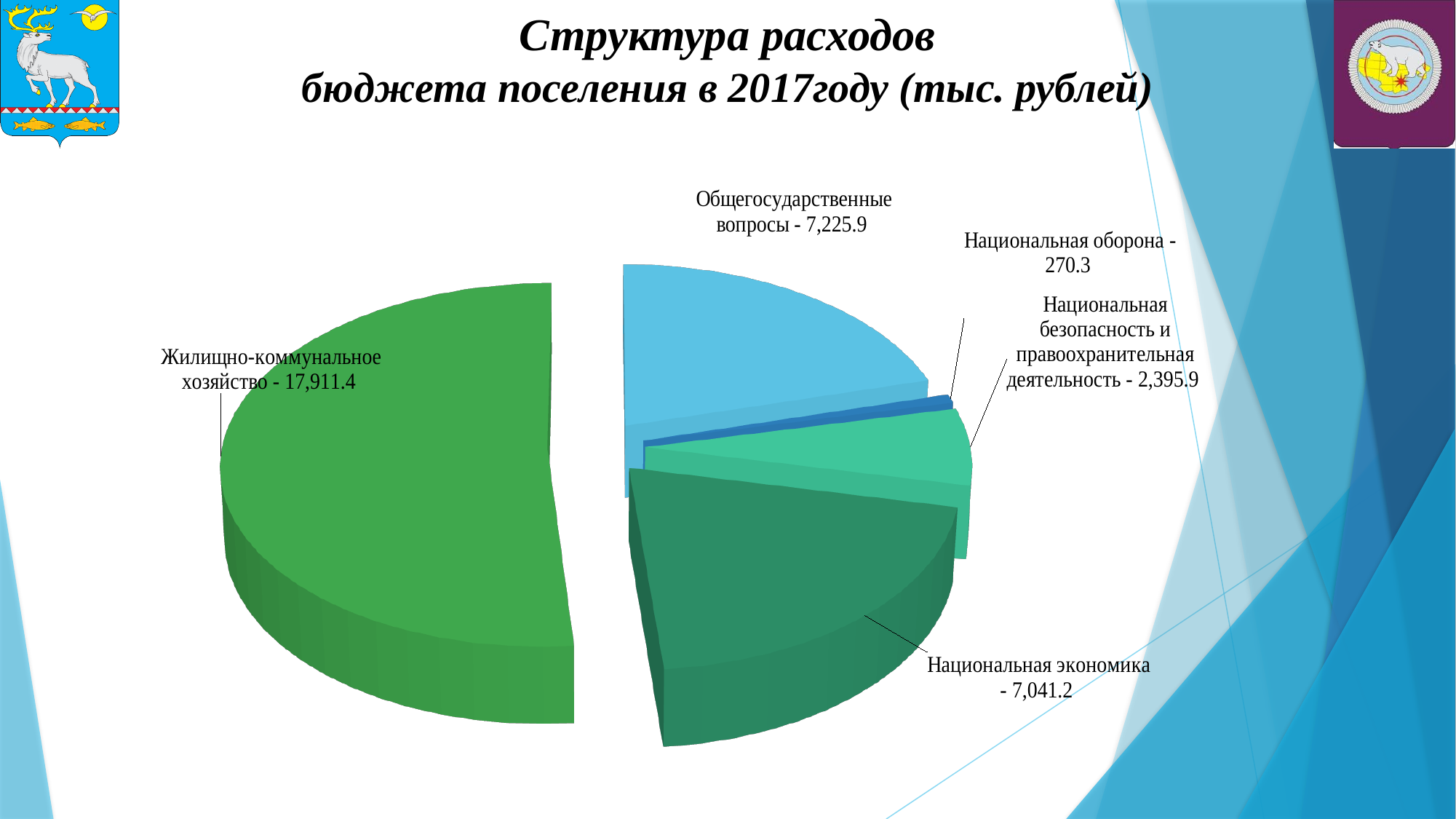
Which is larger: Общегосударственные вопросы or Национальная экономика? Общегосударственные вопросы What is the value for Национальная безопасность и правоохранительная деятельность? 2,395.9 What is the title of the chart? Структура расходов бюджета поселения в 2017году (тыс. рублей) What is the difference between Общегосударственные вопросы and Национальная экономика? 184.7 How many slices does the pie chart have? 5 What is the value for Национальная экономика? 7,041.2 Which category has the smallest value? Национальная оборона What is the value for Общегосударственные вопросы? 7,225.9 What kind of chart is shown on the slide? Pie chart What is the value for Жилищно-коммунальное хозяйство? 17,911.4 What is the value for Национальная оборона? 270.3 Which category has the largest value? Жилищно-коммунальное хозяйство